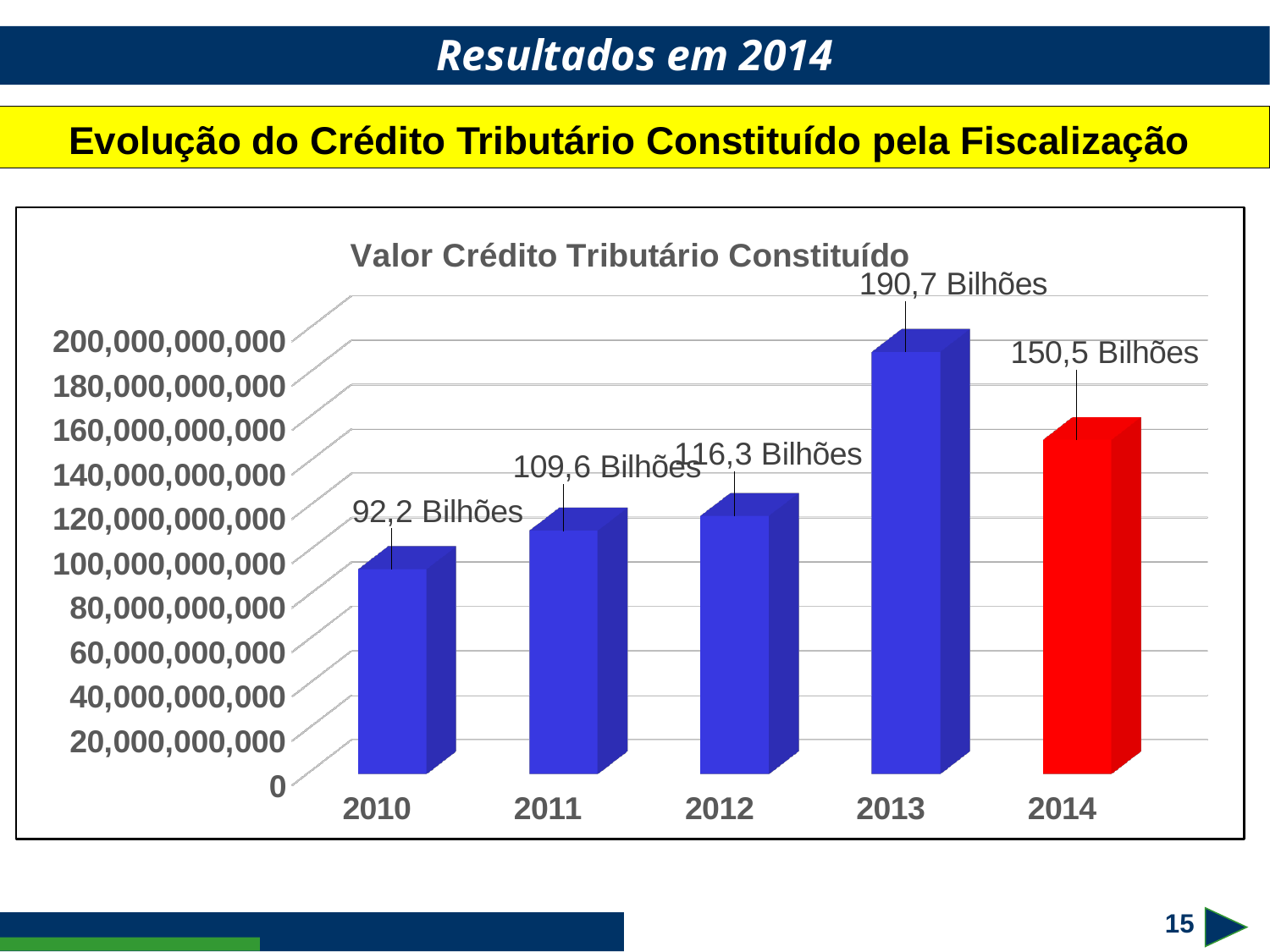
What kind of chart is shown on the slide? bar chart Which year has the highest value? 2013 What is the value for 2013 in the chart? 190,7 Bilhões What is the difference between the values for 2013 and 2014? 40,2 Bilhões What is the value for 2014 in the chart? 150,5 Bilhões Which year has the lowest value? 2010 Do the values rise or fall from 2010 to 2013? rise What is the difference between the values for 2011 and 2010? 17,3 Bilhões Which is larger, the value for 2012 or the value for 2014? 2014 How many years are shown on the x axis? 5 Is the value for 2014 greater or less than 140,000,000,000? greater What is the value for 2010 in the chart? 92,2 Bilhões